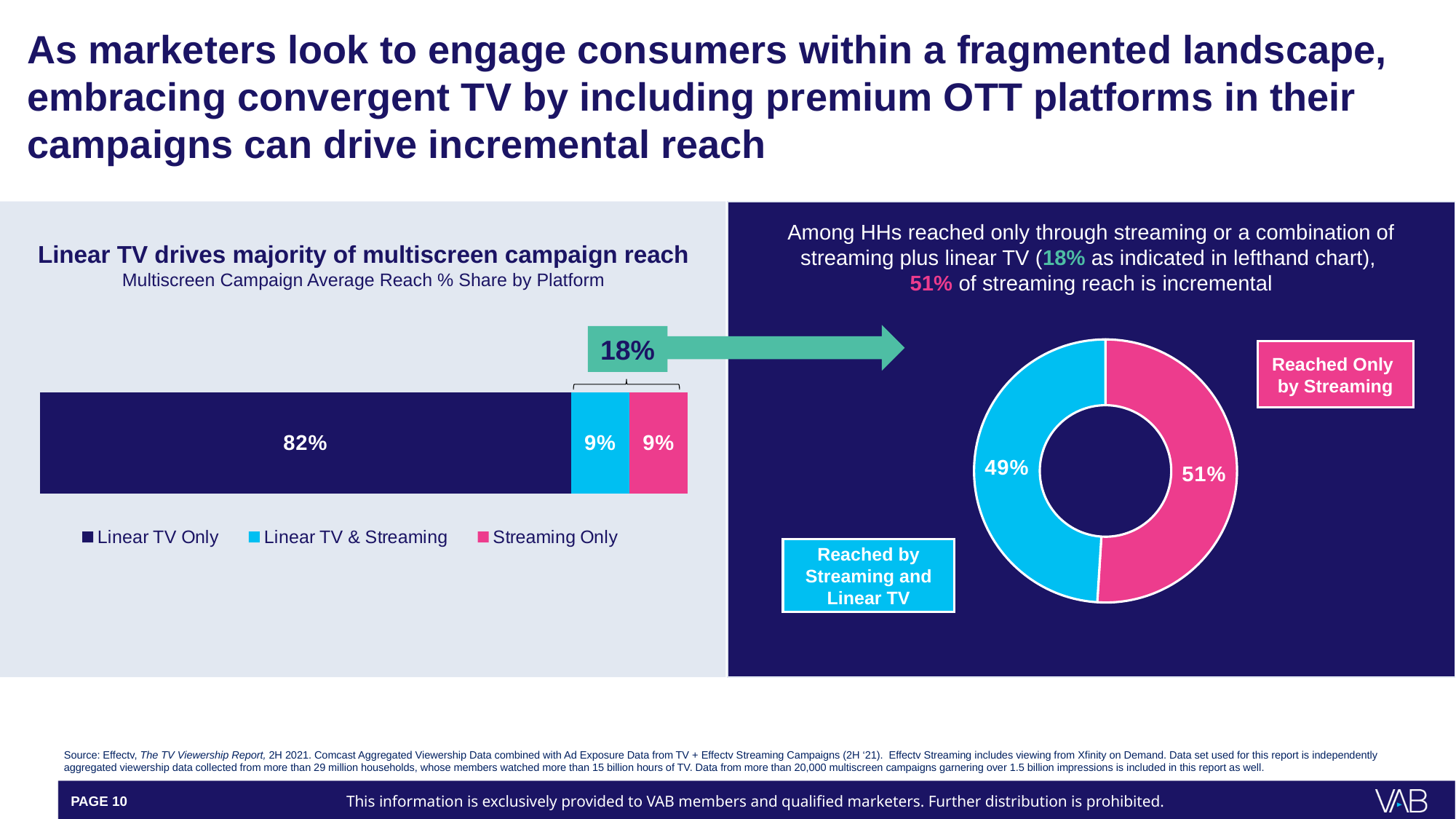
How many segments does the donut chart on the right have? 2 In the left chart titled 'Linear TV drives majority of multiscreen campaign reach', what is the combined share of Linear TV & Streaming and Streaming Only? 18% How many series does the legend of the left chart titled 'Linear TV drives majority of multiscreen campaign reach' list? 3 In the donut chart on the right, which segment is larger: Reached Only by Streaming or Reached by Streaming and Linear TV? Reached Only by Streaming What is the subtitle of the left chart titled 'Linear TV drives majority of multiscreen campaign reach'? Multiscreen Campaign Average Reach % Share by Platform In the donut chart on the right, what share is Reached Only by Streaming? 51% In the left chart titled 'Linear TV drives majority of multiscreen campaign reach', what is the reach share for Streaming Only? 9% In the left chart titled 'Linear TV drives majority of multiscreen campaign reach', what is the reach share for Linear TV Only? 82% What kind of chart is the left chart titled 'Linear TV drives majority of multiscreen campaign reach'? Stacked bar chart In the donut chart on the right, what share is Reached by Streaming and Linear TV? 49% In the left chart titled 'Linear TV drives majority of multiscreen campaign reach', what is the difference between the Linear TV Only share and the Linear TV & Streaming share? 73% In the left chart titled 'Linear TV drives majority of multiscreen campaign reach', which platform segment has the highest reach share? Linear TV Only